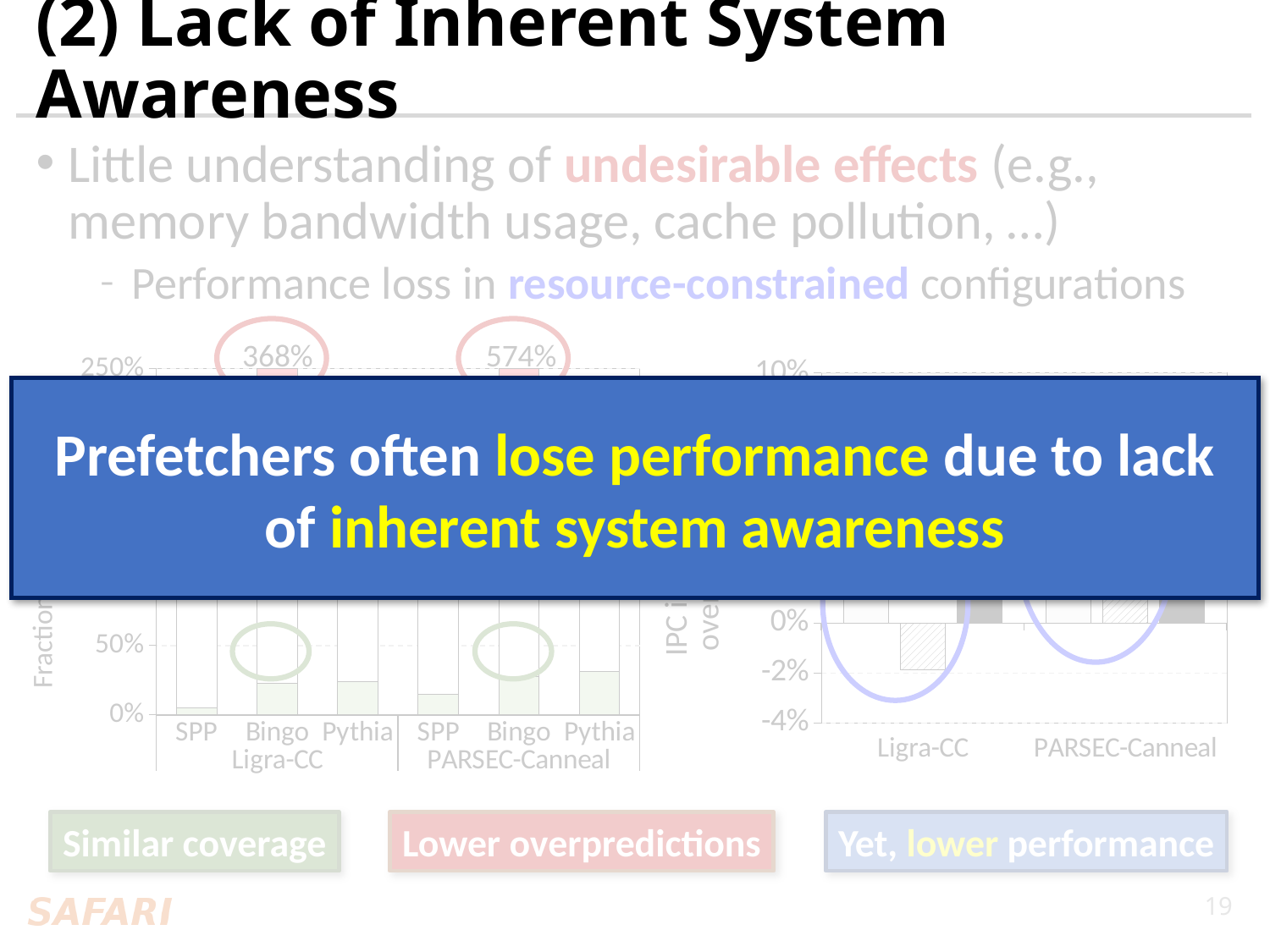
What is the lowest tick value shown on the y axis of the right chart? -4% In the left chart, which three prefetchers are listed under each workload group on the x axis? SPP, Bingo, Pythia In the left chart, what are the two workload groups labelled on the x axis? Ligra-CC and PARSEC-Canneal What kind of chart is the chart on the left side of the slide? bar chart In the right chart, is the hatched bar for Ligra-CC greater or less than 0%? less What kind of chart is the chart on the right side of the slide? bar chart What is the highest tick value shown on the y axis of the right chart? 10% In the right chart, how many workload groups are labelled on the x axis? 2 In the left chart, how many bars are plotted along the x axis? 6 Which of the two circled values annotated above the left chart is larger, 368% or 574%? 574% What is the highest tick value shown on the y axis of the left chart? 250%